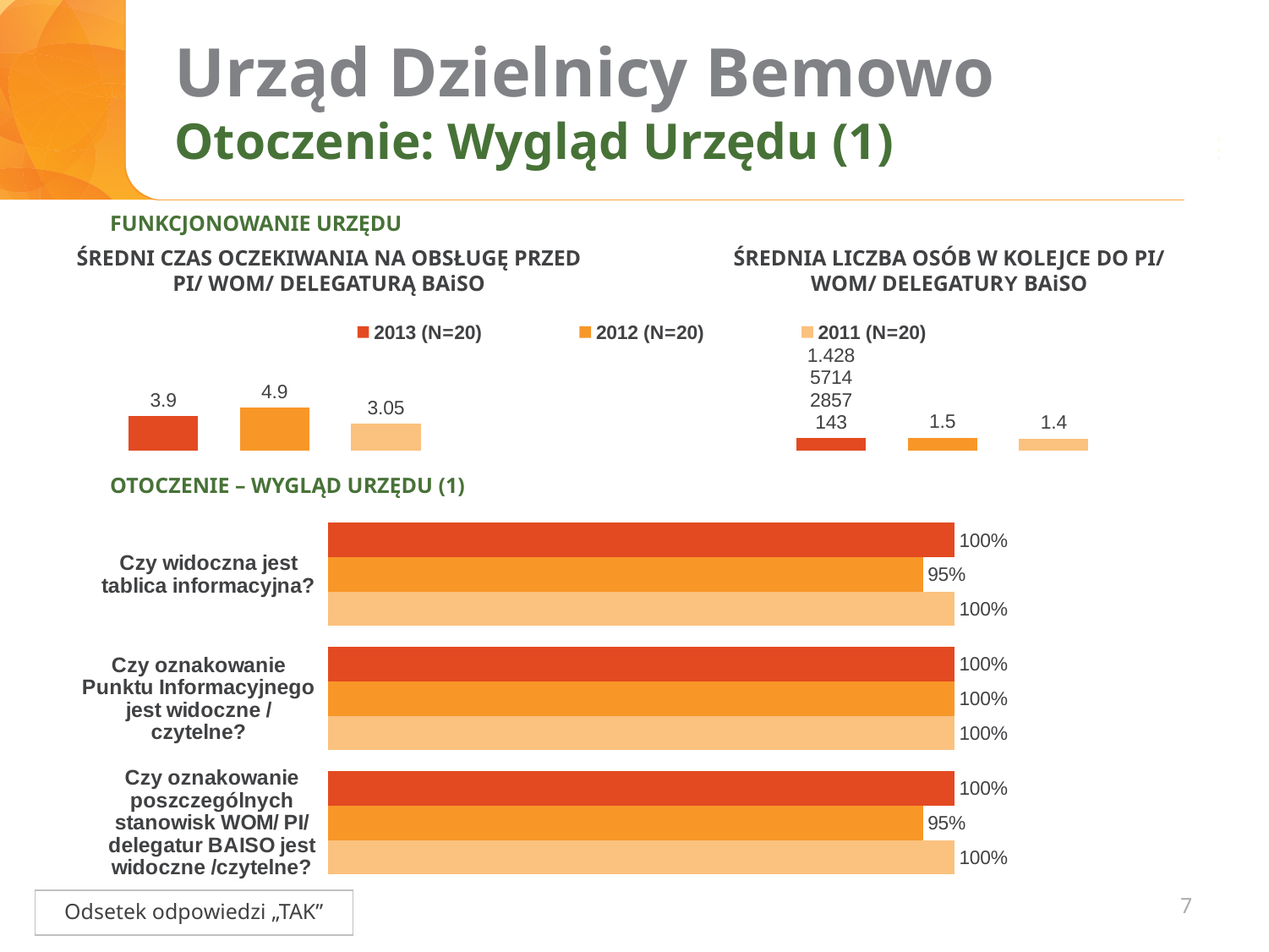
How many series does the legend on the slide list? 3 In the bottom chart 'OTOCZENIE – WYGLĄD URZĘDU (1)', how many question categories are shown? 3 In the chart titled 'ŚREDNIA LICZBA OSÓB W KOLEJCE DO PI/ WOM/ DELEGATURY BAiSO', what is the value for 2011 (N=20)? 1.4 What type of chart is the bottom chart 'OTOCZENIE – WYGLĄD URZĘDU (1)'? Bar chart In the bottom chart 'OTOCZENIE – WYGLĄD URZĘDU (1)', what is the 2012 (N=20) value for 'Czy widoczna jest tablica informacyjna?'? 95% In the chart titled 'ŚREDNI CZAS OCZEKIWANIA NA OBSŁUGĘ PRZED PI/ WOM/ DELEGATURĄ BAiSO', which year has the highest value? 2012 (N=20) In the bottom chart 'OTOCZENIE – WYGLĄD URZĘDU (1)', what is the 2013 (N=20) value for 'Czy oznakowanie Punktu Informacyjnego jest widoczne / czytelne?'? 100% In the chart titled 'ŚREDNI CZAS OCZEKIWANIA NA OBSŁUGĘ PRZED PI/ WOM/ DELEGATURĄ BAiSO', what is the value for 2011 (N=20)? 3.05 In the chart titled 'ŚREDNIA LICZBA OSÓB W KOLEJCE DO PI/ WOM/ DELEGATURY BAiSO', which is larger, the value for 2012 or the value for 2011? 2012 In the chart titled 'ŚREDNI CZAS OCZEKIWANIA NA OBSŁUGĘ PRZED PI/ WOM/ DELEGATURĄ BAiSO', what is the difference between the 2012 and 2013 values? 1.0 In the chart titled 'ŚREDNIA LICZBA OSÓB W KOLEJCE DO PI/ WOM/ DELEGATURY BAiSO', what is the value for 2012 (N=20)? 1.5 In the chart titled 'ŚREDNI CZAS OCZEKIWANIA NA OBSŁUGĘ PRZED PI/ WOM/ DELEGATURĄ BAiSO', what is the value for 2012 (N=20)? 4.9